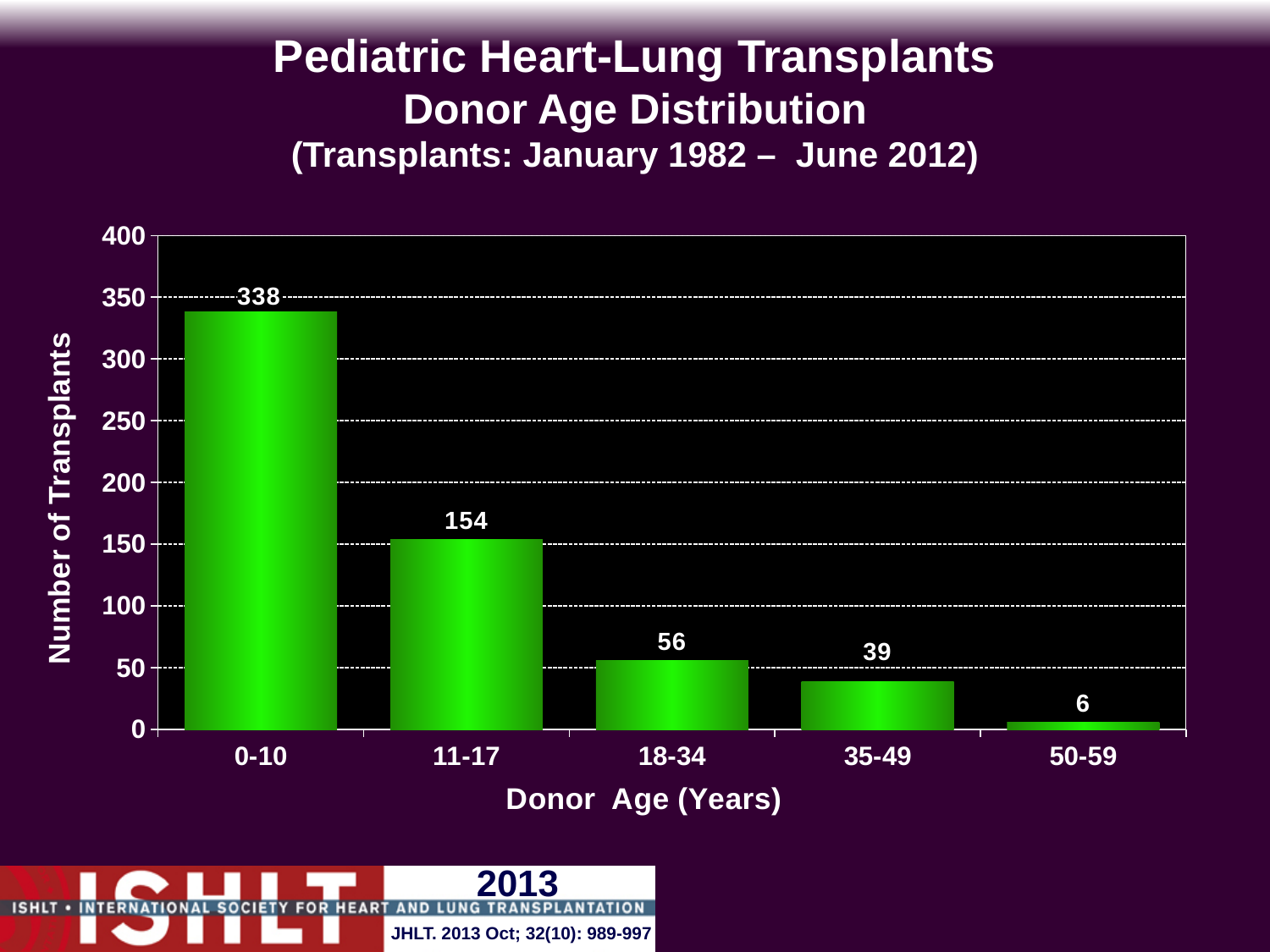
Which donor age group has the lowest number of transplants? 50-59 What is the number of transplants for donors aged 11-17? 154 Is the value for the 11-17 donor age group greater or less than 150? greater What kind of chart is shown on the slide? Bar chart How many transplants are shown for the 0-10 donor age group? 338 What is the number of transplants for donors aged 50-59? 6 What is the difference in number of transplants between the 0-10 and 11-17 donor age groups? 184 Do the values rise or fall as donor age increases along the x axis? Fall Which has more transplants: donors aged 18-34 or donors aged 35-49? 18-34 How many donor age groups are shown on the x axis? 5 What is the difference in number of transplants between the 18-34 and 35-49 donor age groups? 17 Which donor age group has the highest number of transplants? 0-10